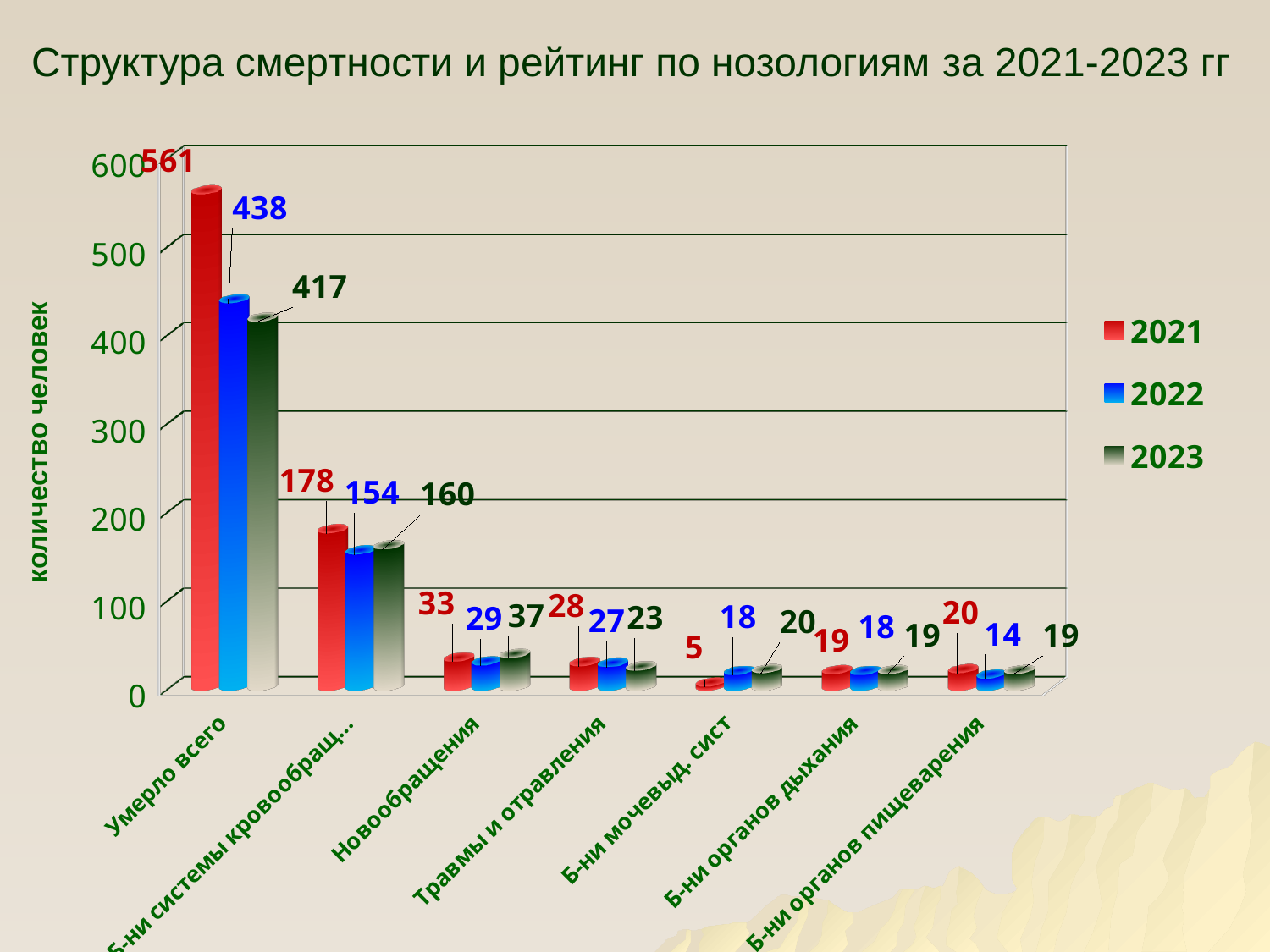
What is the difference between the 2021 and 2023 values in the category "Умерло всего"? 144 What kind of chart is shown on the slide? Bar chart What is the value for 2023 in the category "Новообращения"? 37 How many series does the legend list? 3 Which category has the lowest value for the 2021 series? Б-ни мочевыд. сист Which category has the highest value for the 2022 series? Умерло всего In the category "Новообращения", which series has the larger value, 2021 or 2023? 2023 What is the value for 2021 in the category "Умерло всего"? 561 What is the value for 2022 in the category "Б-ни органов пищеварения"? 14 What is the value for 2021 in the category "Б-ни мочевыд. сист"? 5 How many categories are shown on the x axis? 7 What is the difference between the 2021 and 2022 values in the category "Травмы и отравления"? 1